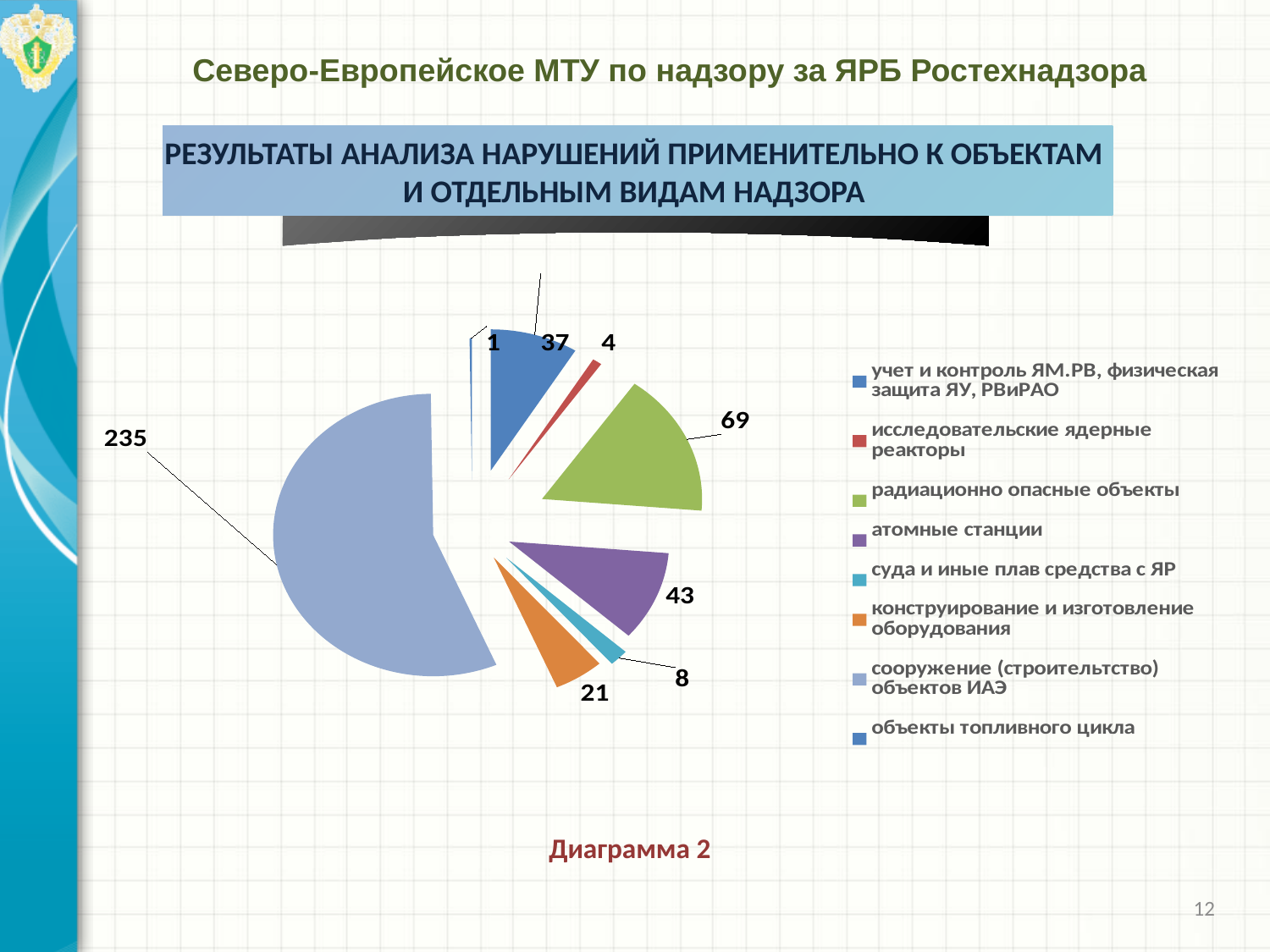
Which is larger: the value for "конструирование и изготовление оборудования" or the value for "суда и иные плав средства с ЯР"? конструирование и изготовление оборудования What is the value for "радиационно опасные объекты" in the pie chart? 69 How many entries does the legend of the pie chart list? 8 What caption is shown below the pie chart? Диаграмма 2 What type of chart is shown on the slide? pie chart What is the value for "исследовательские ядерные реакторы" in the pie chart? 4 Which category has the smallest slice in the pie chart? объекты топливного цикла How many slices does the pie chart have? 8 What is the value for "сооружение (строительство) объектов ИАЭ" in the pie chart? 235 What is the difference between the values for "радиационно опасные объекты" and "атомные станции"? 26 Which category has the largest slice in the pie chart? сооружение (строительство) объектов ИАЭ What is the value for "атомные станции" in the pie chart? 43